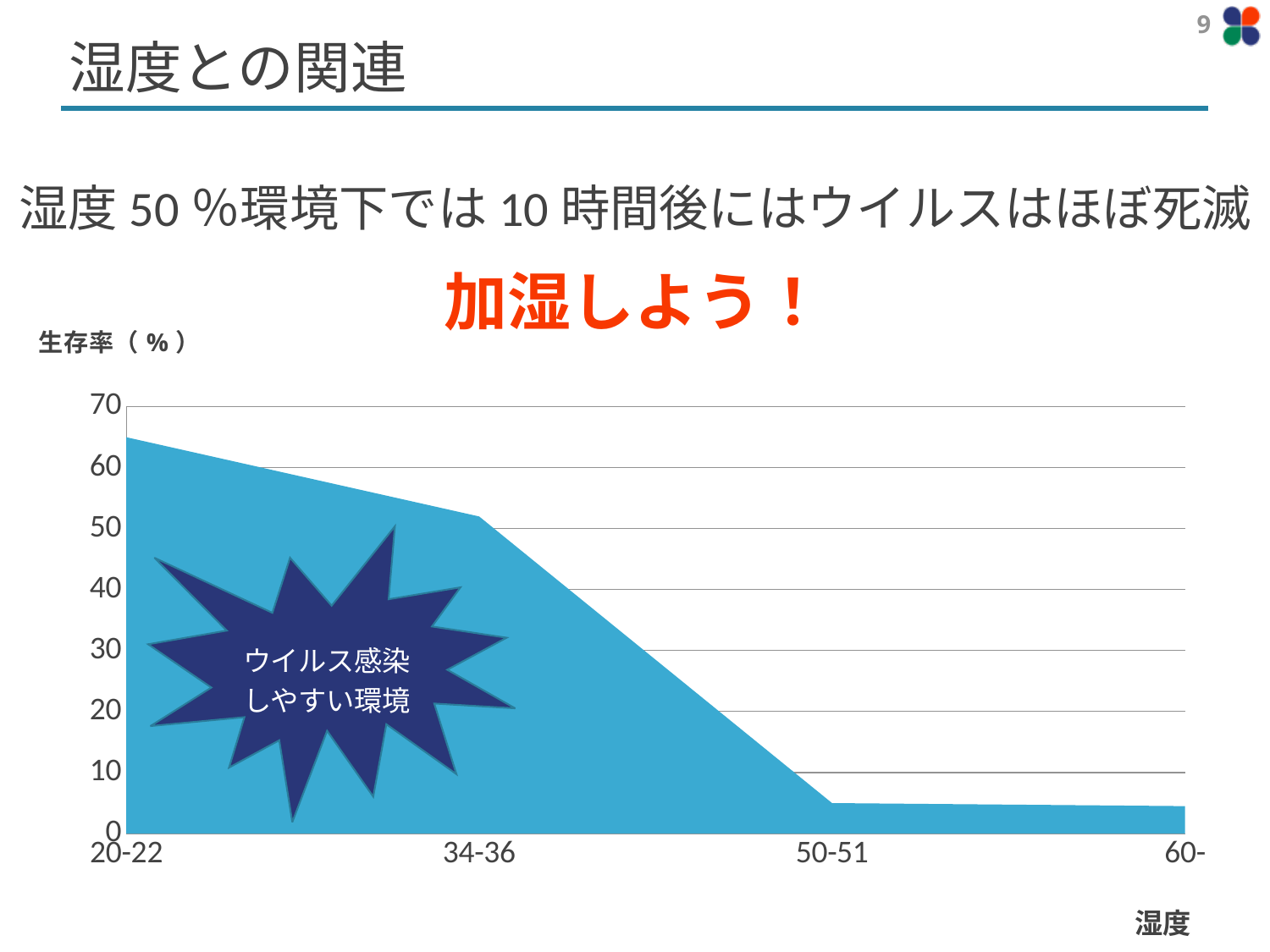
What is the highest value shown on the y axis? 70 Is the value for 60- greater or less than 10? less Which is larger, the value for 34-36 or the value for 50-51? 34-36 Is the value for 34-36 greater or less than 60? less Is the value for 20-22 greater or less than 60? greater Which humidity category has the highest survival rate? 20-22 What is the label of the y axis? 生存率（%） What is the label of the x axis? 湿度 What kind of chart is shown on the slide? area chart Do the values rise or fall as humidity increases along the x axis? fall